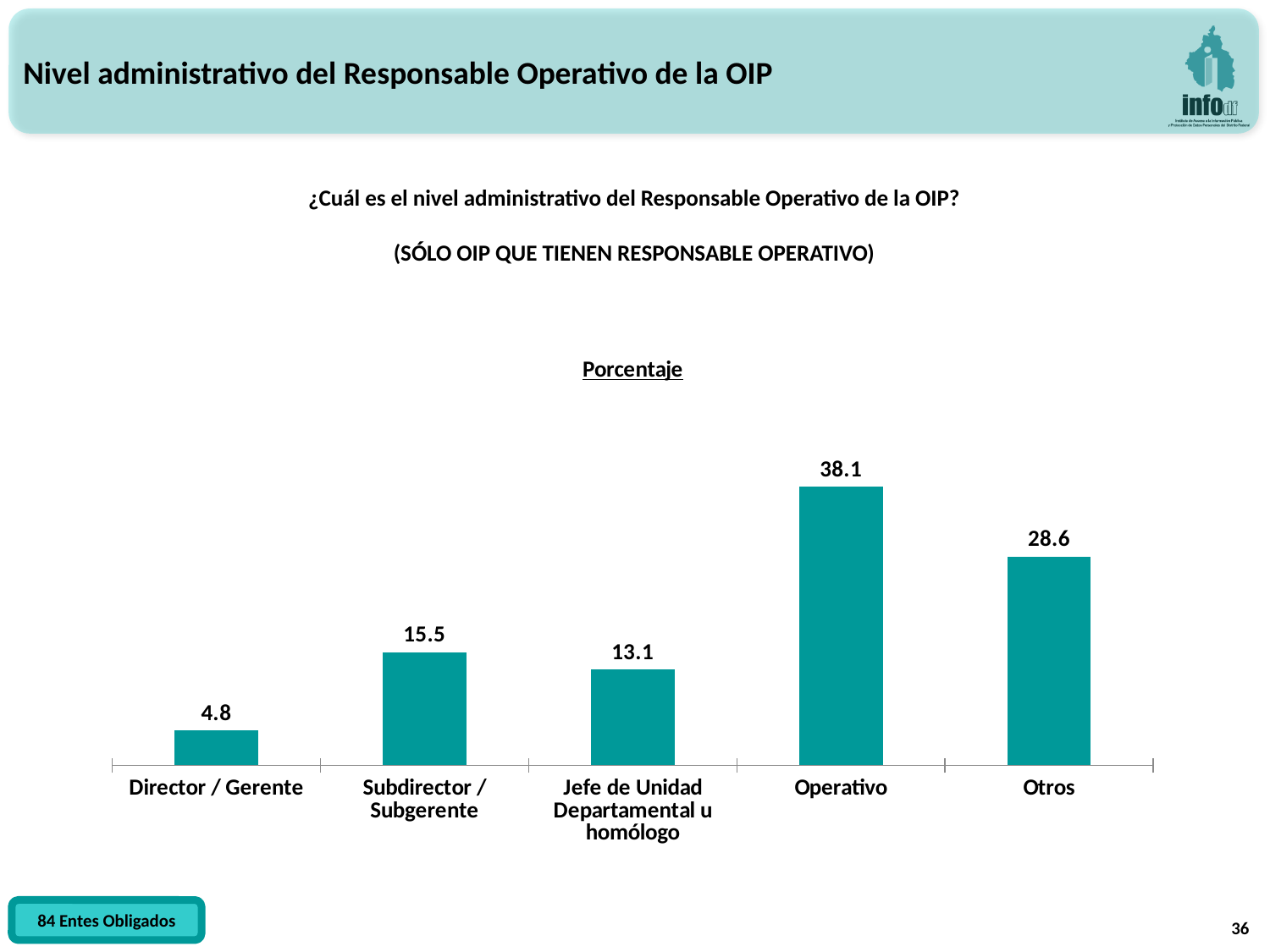
What is the value for Otros? 28.6 How many categories are shown on the x axis? 5 What kind of chart is shown on the slide? Bar chart What is the difference between the values for Operativo and Otros? 9.5 What is the value for Director / Gerente? 4.8 What is the value for Operativo? 38.1 What is the value for Jefe de Unidad Departamental u homólogo? 13.1 What is the title shown above the chart? Porcentaje Which category has the lowest value? Director / Gerente What is the difference between the values for Subdirector / Subgerente and Director / Gerente? 10.7 Which category has the highest value? Operativo Which is larger, the value for Subdirector / Subgerente or the value for Jefe de Unidad Departamental u homólogo? Subdirector / Subgerente